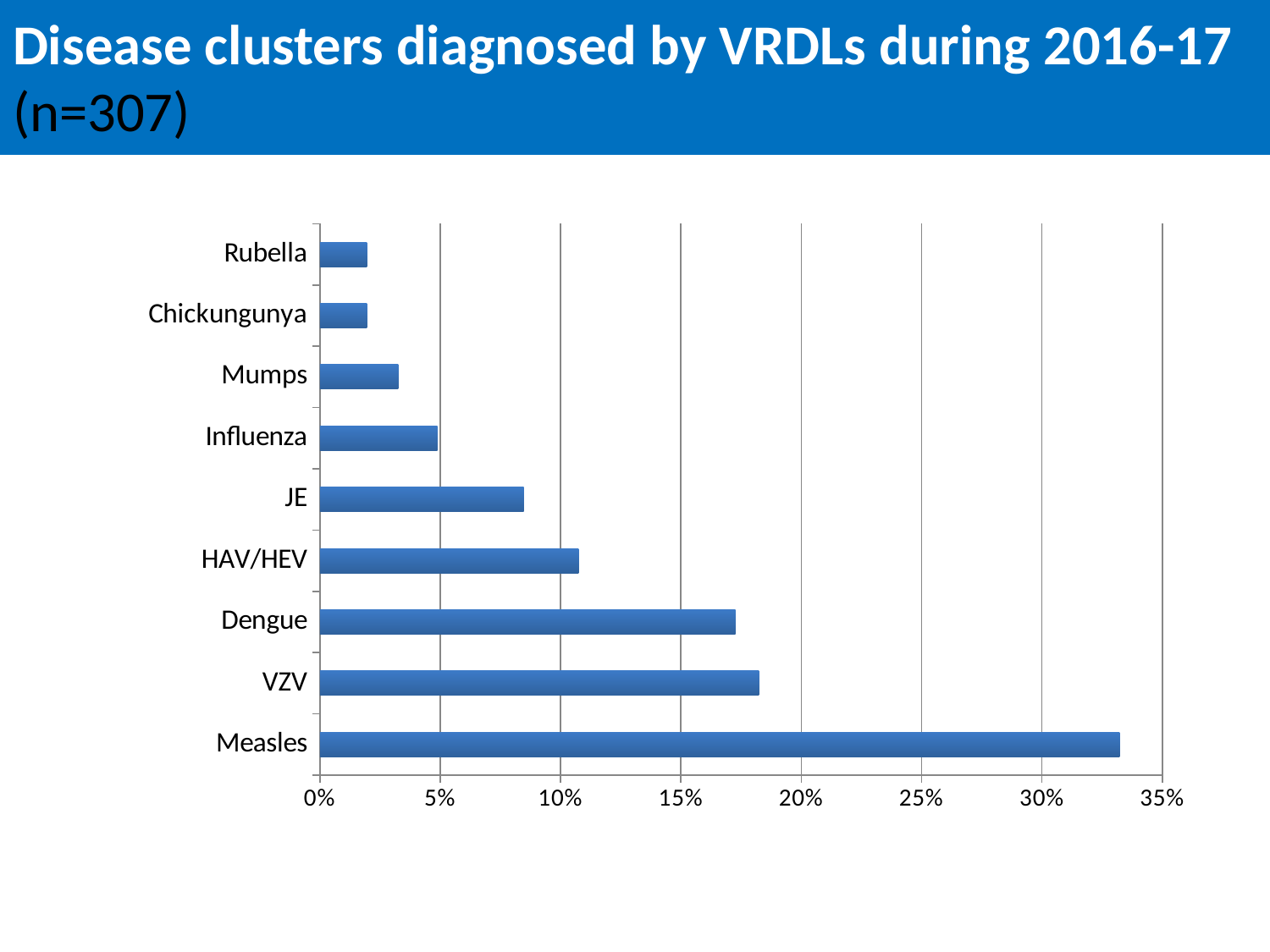
How many disease categories are plotted in the chart? 9 Is the value for JE greater or less than 10%? less Is the value for Measles greater or less than 30%? greater Is the value for HAV/HEV greater or less than 10%? greater What is the title of the slide containing the chart? Disease clusters diagnosed by VRDLs during 2016-17 (n=307) Which disease has the highest share of clusters in the chart? Measles What kind of chart is shown on the slide? bar chart Which is larger, the value for Dengue or the value for HAV/HEV? Dengue Which is larger, the value for Measles or the value for VZV? Measles